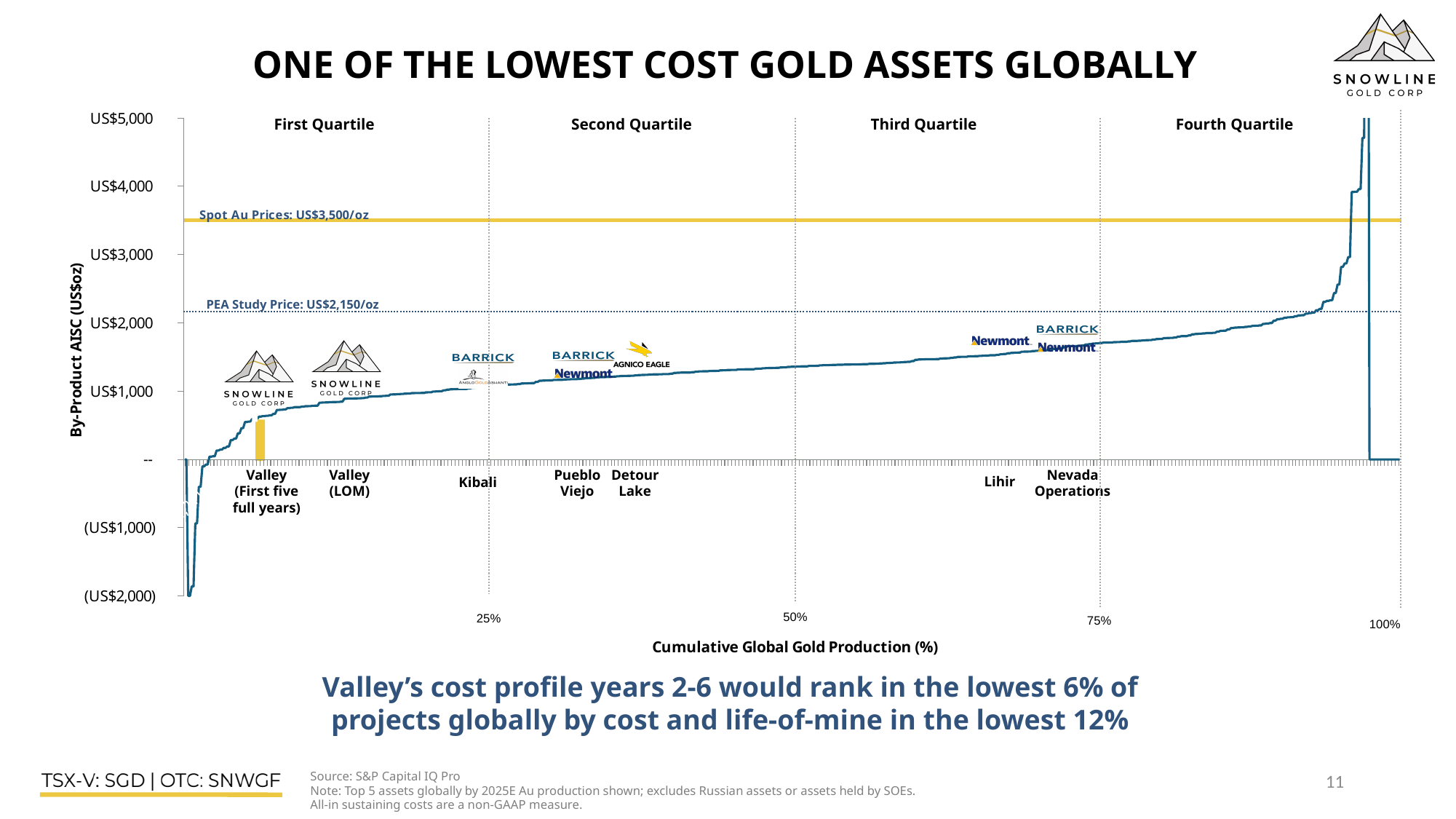
Is the by-product AISC for Lihir greater or less than US$2,000? less What is the title of the x axis of the chart? Cumulative Global Gold Production (%) Is the by-product AISC for Detour Lake greater or less than US$1,000? greater What is the difference between the Spot Au Price and the PEA Study Price shown on the chart? US$1,350/oz Is the by-product AISC for Valley (First five full years) greater or less than US$1,000? less Which labelled asset has the lowest by-product AISC on the cost curve? Valley (First five full years) Does the cost curve rise or fall as cumulative global gold production increases along the x axis? rise What PEA study price is marked on the chart? US$2,150/oz How many quartile sections are labelled across the top of the chart? 4 What kind of chart is shown on the slide? line chart What spot gold price is marked by the horizontal line on the chart? US$3,500/oz Which has the lower by-product AISC on the chart, Valley (First five full years) or Nevada Operations? Valley (First five full years)